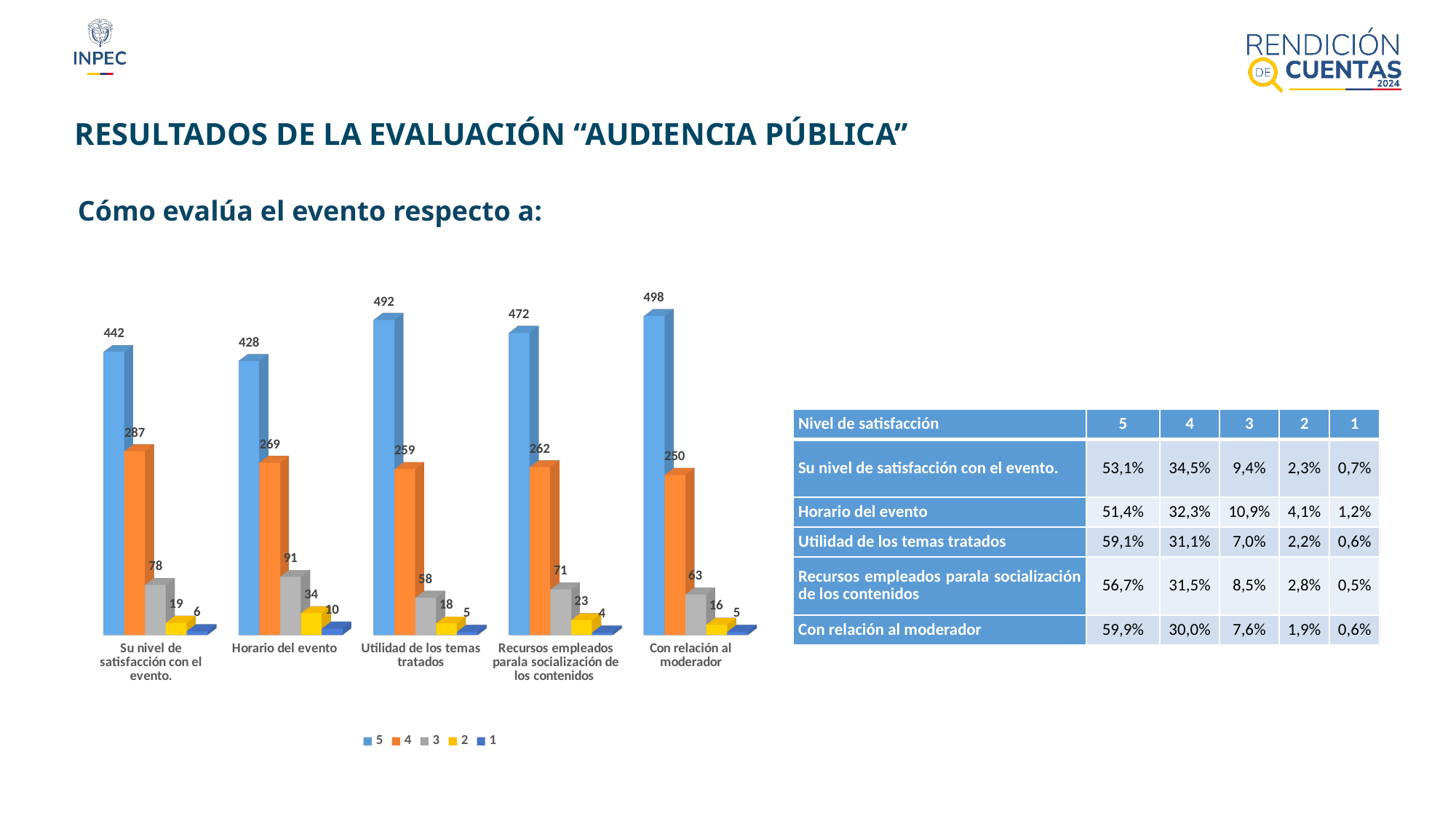
How many categories are shown on the x axis of the chart? 5 Which category has the highest value for series 5? Con relación al moderador What kind of chart is shown on the slide? Bar chart Which is larger: the series 4 value for "Su nivel de satisfacción con el evento" or for "Recursos empleados para la socialización de los contenidos"? Su nivel de satisfacción con el evento What value does series 4 have for "Horario del evento"? 269 What value does series 5 have for "Con relación al moderador"? 498 What value does series 2 have for "Recursos empleados para la socialización de los contenidos"? 23 Which colour represents series 2 in the chart legend? Yellow What value does series 3 have for "Utilidad de los temas tratados"? 58 What is the difference between the series 5 values for "Utilidad de los temas tratados" and "Su nivel de satisfacción con el evento"? 50 Which category has the lowest value for series 1? Recursos empleados para la socialización de los contenidos How many series does the chart legend list? 5